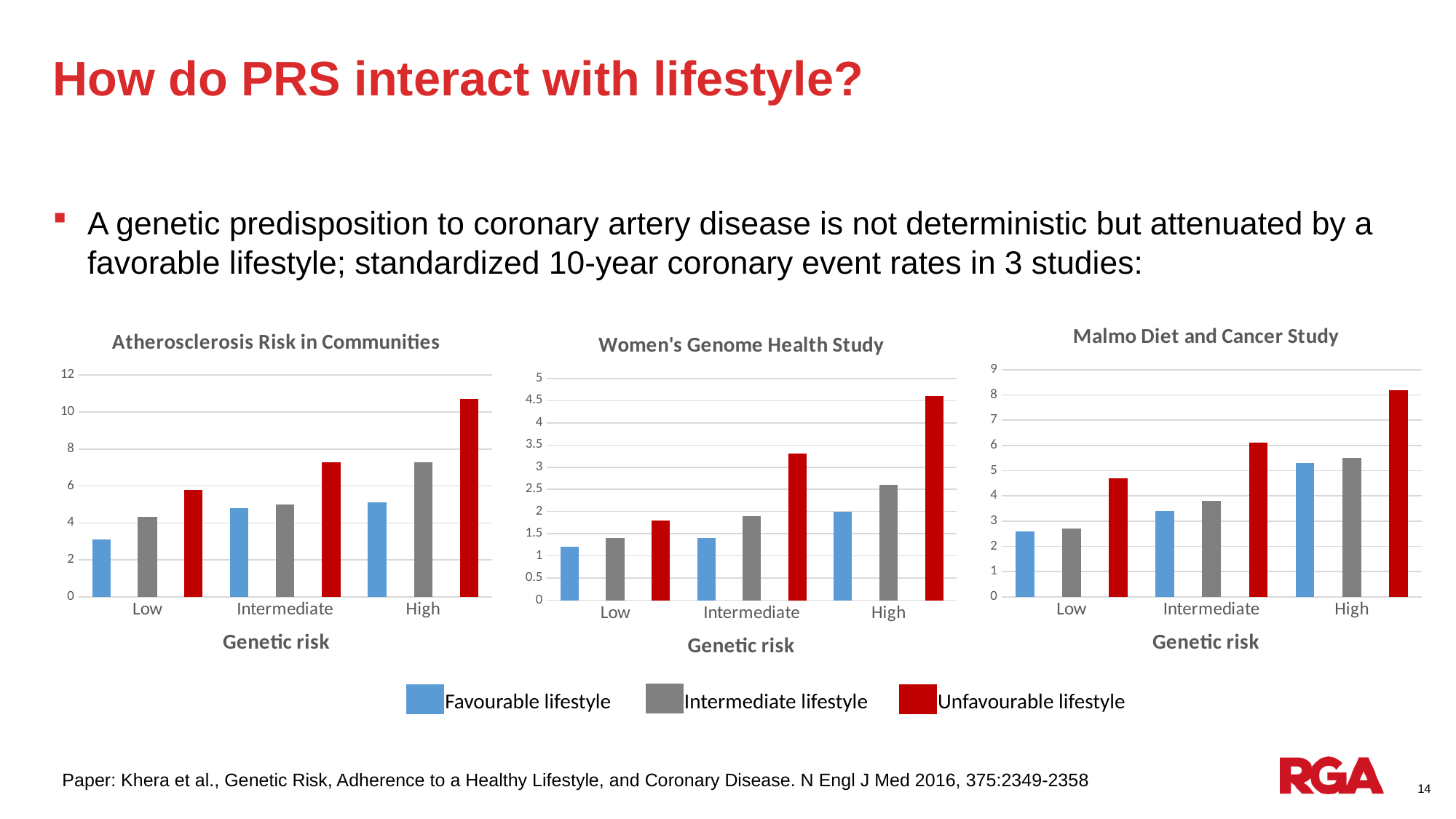
In the Malmo Diet and Cancer Study chart, at Intermediate genetic risk, which is larger: Favourable lifestyle or Unfavourable lifestyle? Unfavourable lifestyle In the Atherosclerosis Risk in Communities chart, is the value for Favourable lifestyle at Low genetic risk greater or less than 4? less In the Atherosclerosis Risk in Communities chart, which bar is the highest? Unfavourable lifestyle at High genetic risk In the Women's Genome Health Study chart, is the value for Unfavourable lifestyle at High genetic risk greater or less than 4? greater In the Women's Genome Health Study chart, do the Unfavourable lifestyle values rise or fall from Low to High genetic risk? rise How many series does the shared legend list for the three charts? 3 In the Malmo Diet and Cancer Study chart, is the value for Favourable lifestyle at Low genetic risk greater or less than 3? less What colour represents Unfavourable lifestyle in the legend? red What kind of chart is the Atherosclerosis Risk in Communities chart? bar chart In the Women's Genome Health Study chart, which bar is the lowest? Favourable lifestyle at Low genetic risk In the Women's Genome Health Study chart, how many genetic risk categories are shown on the x axis? 3